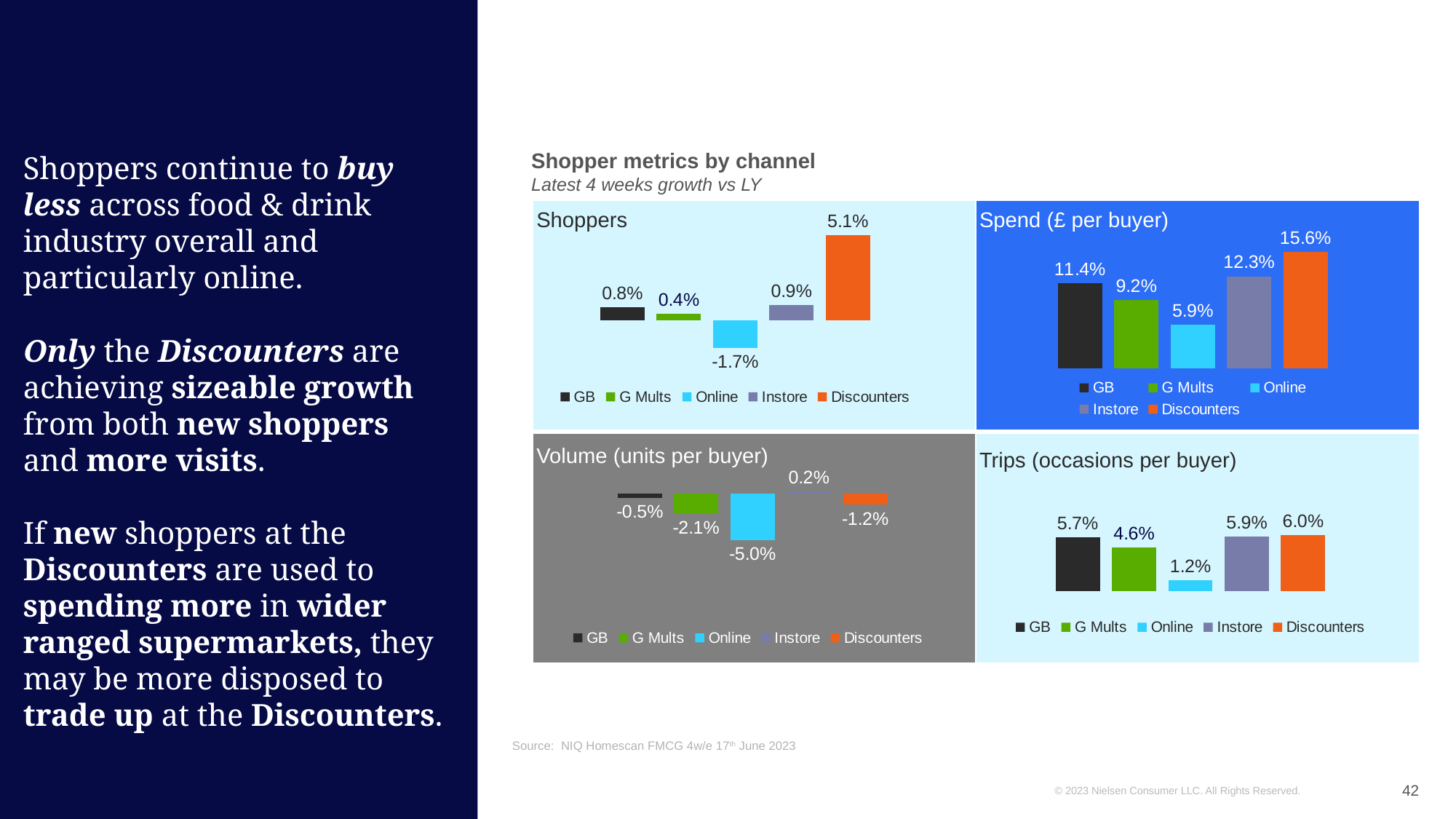
In the Spend (£ per buyer) chart, what is the difference between Discounters and GB? 4.2% In the Shoppers chart, which is larger, the value for GB or the value for Instore? Instore In the Shoppers chart, what is the value for Online? -1.7% In the Trips (occasions per buyer) chart, what is the value for G Mults? 4.6% In the Volume (units per buyer) chart, what is the value for Instore? 0.2% What kind of chart is the Trips (occasions per buyer) chart? Bar chart In the Volume (units per buyer) chart, which channel has the lowest value? Online In the Trips (occasions per buyer) chart, which channel has the lowest value? Online In the Spend (£ per buyer) chart, what is the value for Instore? 12.3% In the Spend (£ per buyer) chart, which channel has the highest value? Discounters In the Shoppers chart, what is the value for Discounters? 5.1% How many channels are shown in the Spend (£ per buyer) chart? 5